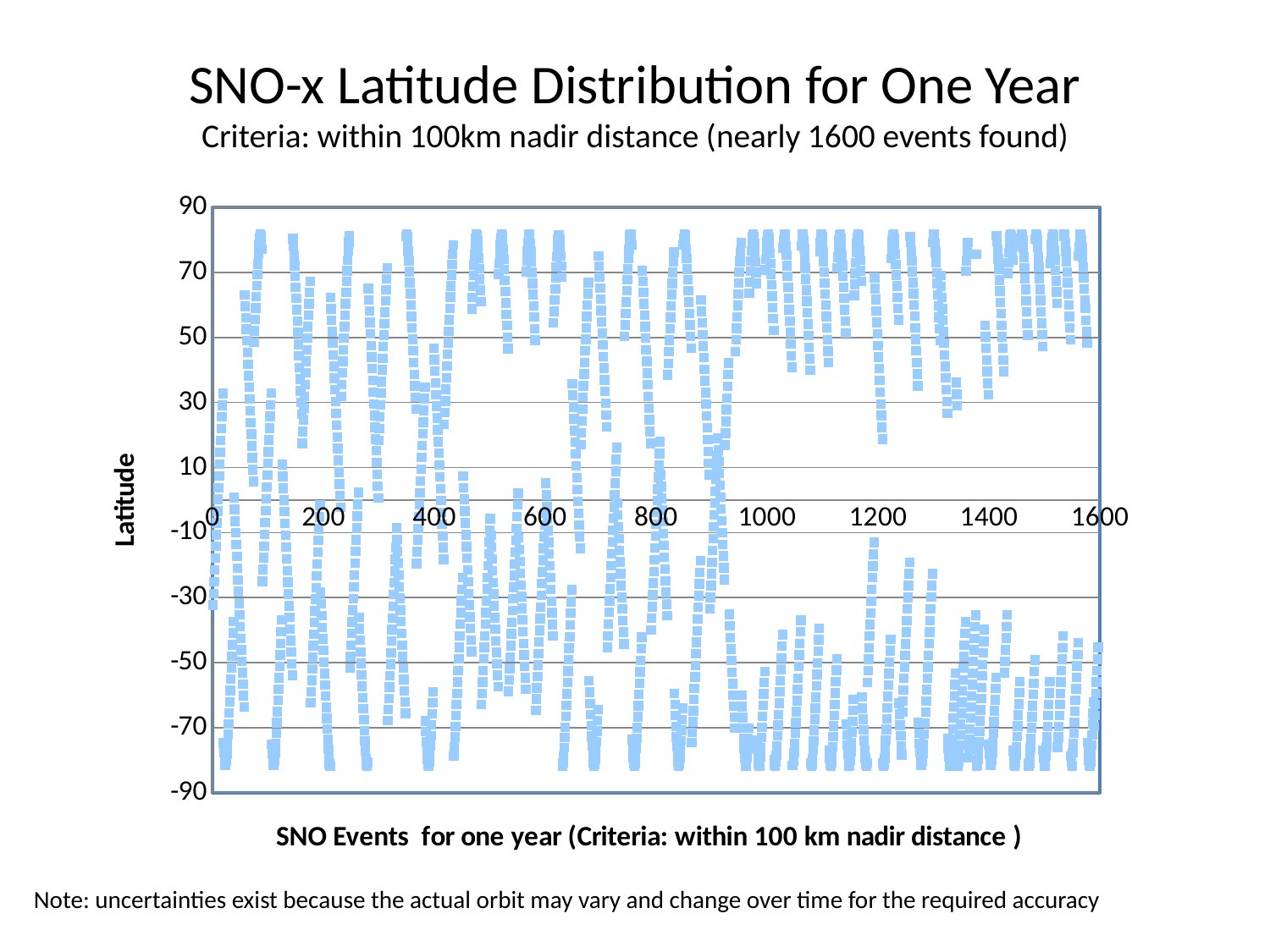
What kind of chart is shown on the slide? Scatter chart What is the label of the vertical axis of the chart? Latitude What is the largest tick value shown on the horizontal axis of the chart? 1600 Is the highest latitude plotted in the chart greater or less than 90? less What is the highest value shown on the vertical axis of the chart? 90 What is the spacing between consecutive tick labels on the vertical axis of the chart? 20 What is the title printed below the chart's horizontal axis? SNO Events for one year (Criteria: within 100 km nadir distance ) Is the lowest latitude plotted in the chart greater or less than -90? greater What is the lowest value shown on the vertical axis of the chart? -90 How many tick labels are shown on the horizontal axis of the chart? 9